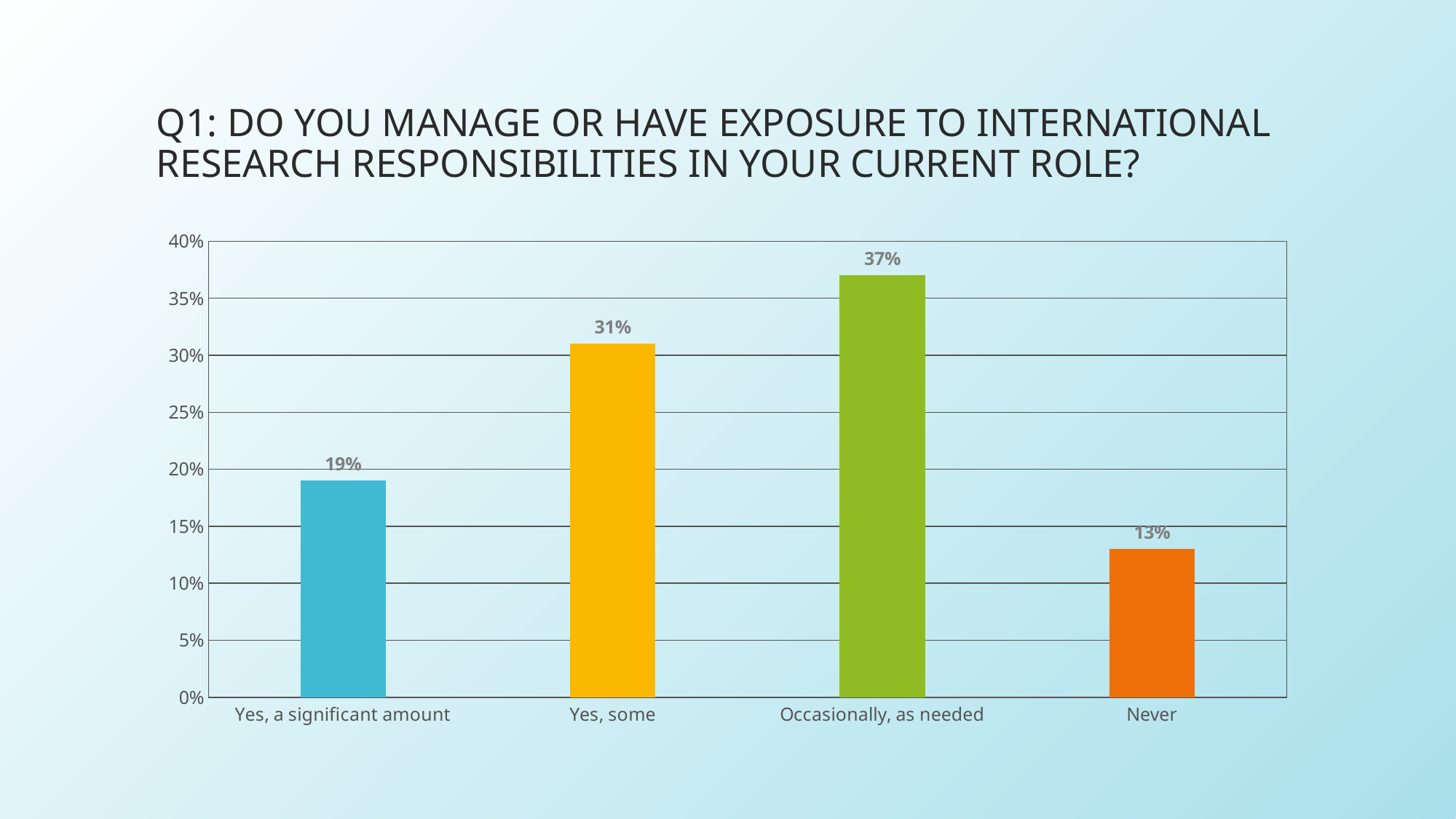
What is the value for "Yes, some"? 31% How many categories are shown on the x axis? 4 Which category has the lowest value? Never What is the value for "Occasionally, as needed"? 37% What is the value for "Yes, a significant amount"? 19% Is the value for "Never" greater or less than 15%? less What kind of chart is shown on the slide? Bar chart What is the difference between the values for "Occasionally, as needed" and "Yes, some"? 6% Which is larger, the value for "Yes, some" or the value for "Yes, a significant amount"? Yes, some Which category has the highest value? Occasionally, as needed What is the value for "Never"? 13% What is the difference between the values for "Yes, a significant amount" and "Never"? 6%